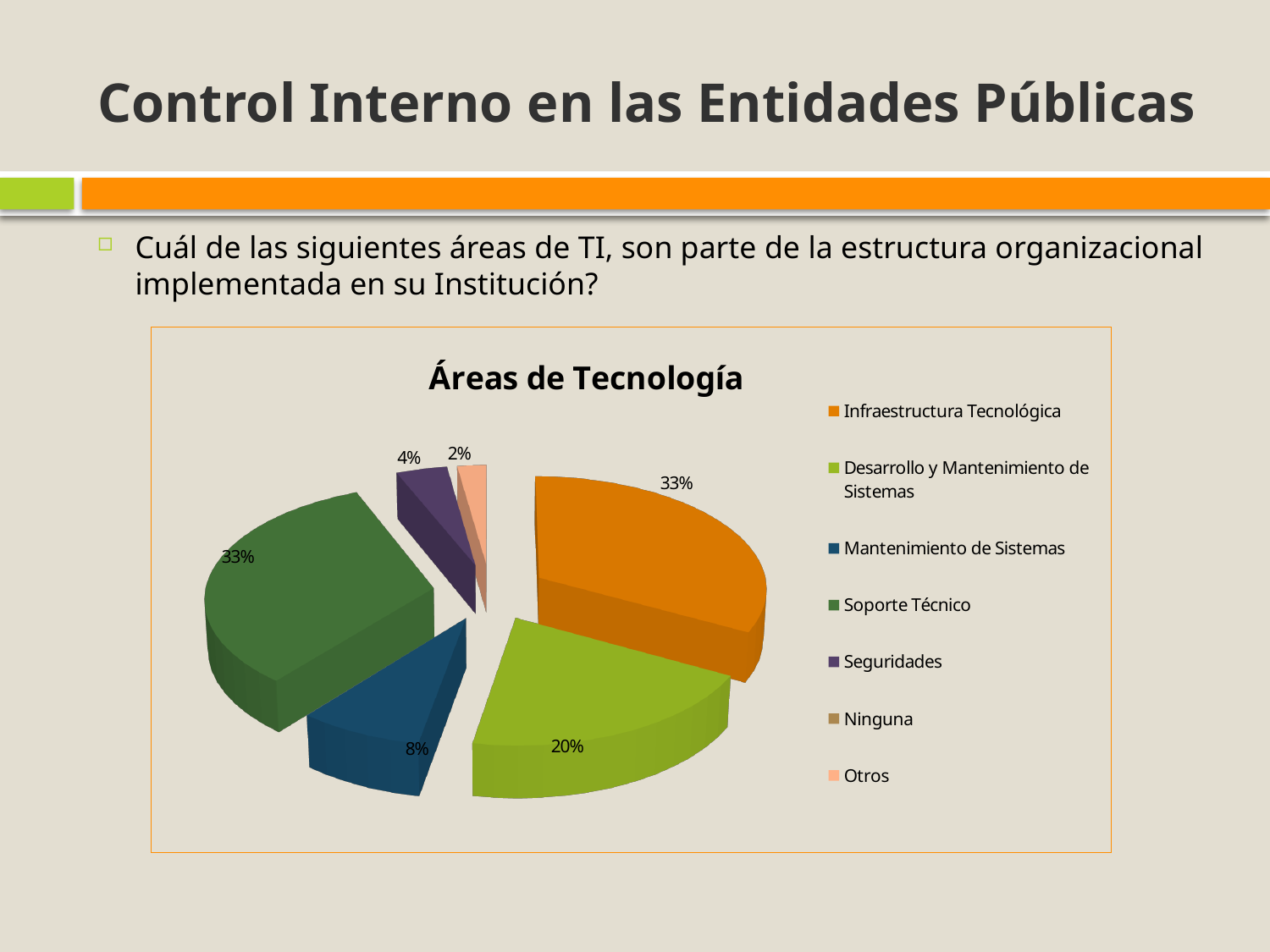
What percentage is shown for Desarrollo y Mantenimiento de Sistemas? 20% What percentage is shown for Seguridades? 4% What kind of chart is shown on the slide? Pie chart What percentage does the Infraestructura Tecnológica slice show in the Áreas de Tecnología pie chart? 33% What percentage is shown for Otros? 2% Which is larger, Desarrollo y Mantenimiento de Sistemas or Mantenimiento de Sistemas? Desarrollo y Mantenimiento de Sistemas How many categories does the legend of the chart list? 7 What is the title of the chart? Áreas de Tecnología What percentage is shown for Mantenimiento de Sistemas? 8% What is the difference in percentage points between Infraestructura Tecnológica and Desarrollo y Mantenimiento de Sistemas? 13% Which is larger, Seguridades or Otros? Seguridades What percentage does the Soporte Técnico slice show? 33%